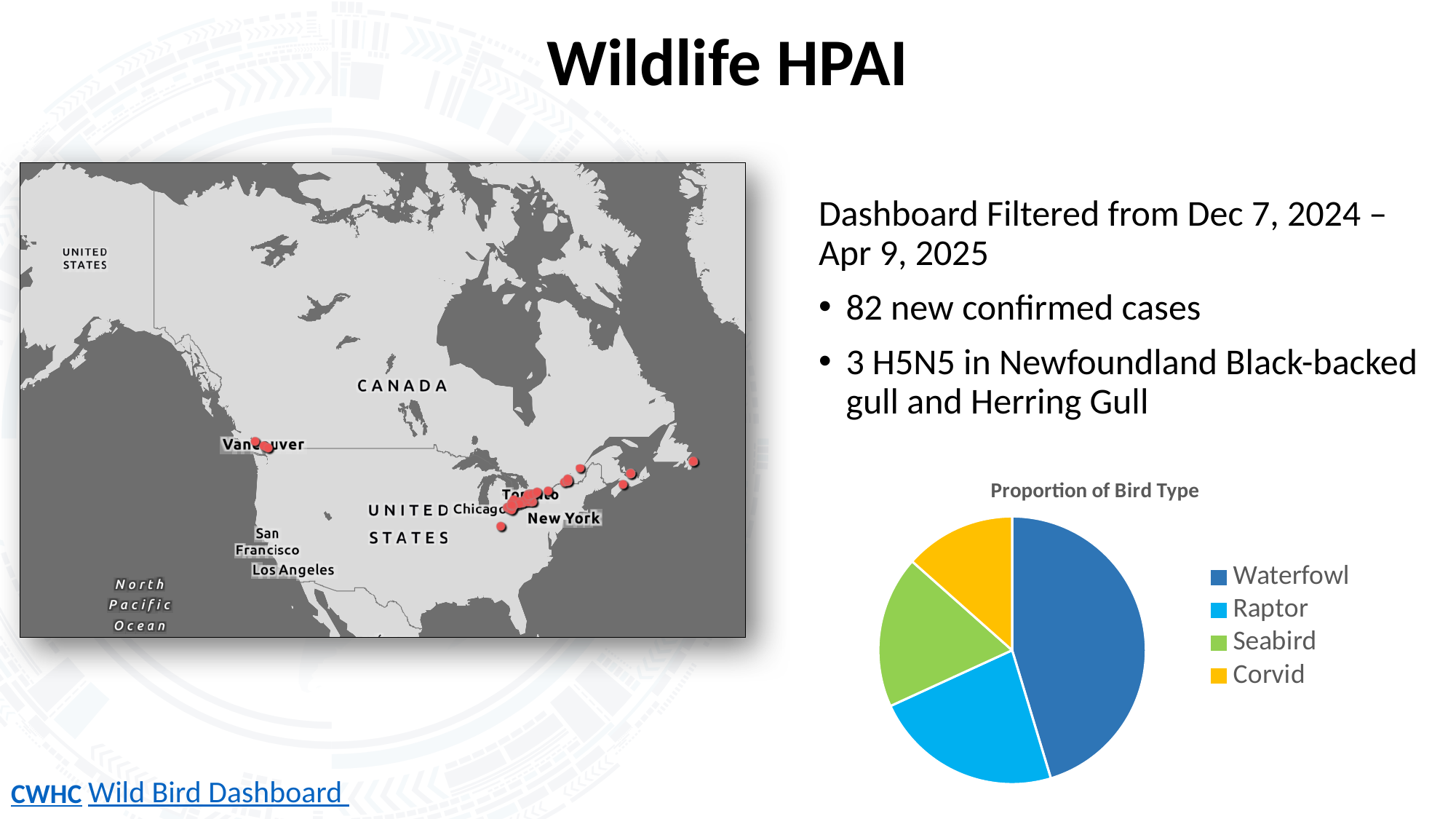
What kind of chart is the 'Proportion of Bird Type' chart? pie chart Which bird type has the largest slice in the 'Proportion of Bird Type' pie chart? Waterfowl How many bird types are shown in the 'Proportion of Bird Type' pie chart? 4 What is the title of the pie chart on the slide? Proportion of Bird Type What colour is the Corvid slice in the 'Proportion of Bird Type' pie chart? yellow In the 'Proportion of Bird Type' pie chart, which slice is larger, Waterfowl or Raptor? Waterfowl In the 'Proportion of Bird Type' pie chart, which slice is larger, Raptor or Corvid? Raptor How many entries does the legend of the 'Proportion of Bird Type' chart list? 4